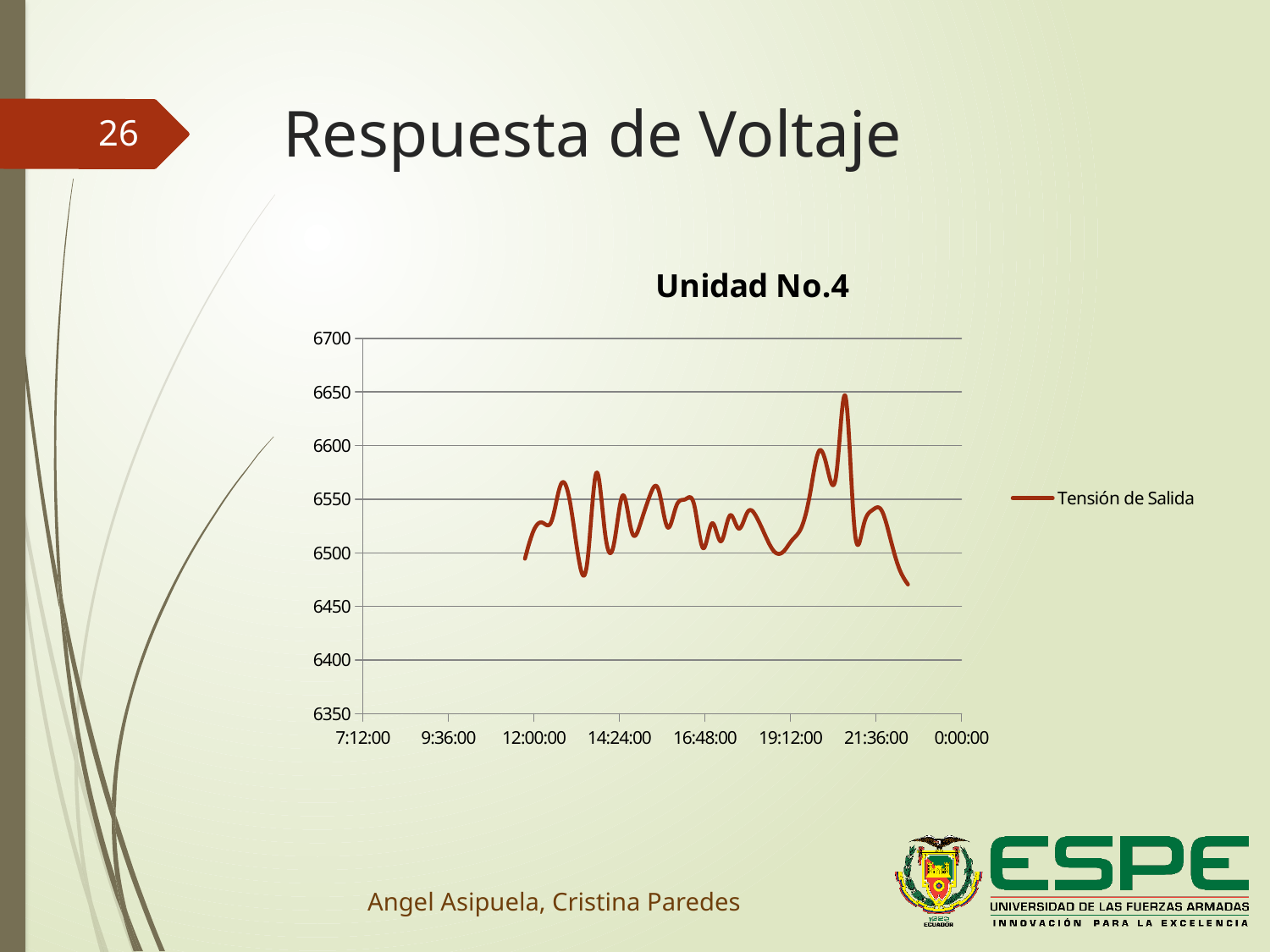
Is the highest value of Tensión de Salida greater or less than 6600? greater Is the lowest value of Tensión de Salida greater or less than 6450? greater Is the lowest value of Tensión de Salida greater or less than 6500? less How many series does the legend list? 1 What is the title of the chart? Unidad No.4 What is the name of the series shown in the legend? Tensión de Salida What kind of chart is shown on the slide? line chart Is the peak of Tensión de Salida reached before or after 19:12:00? after